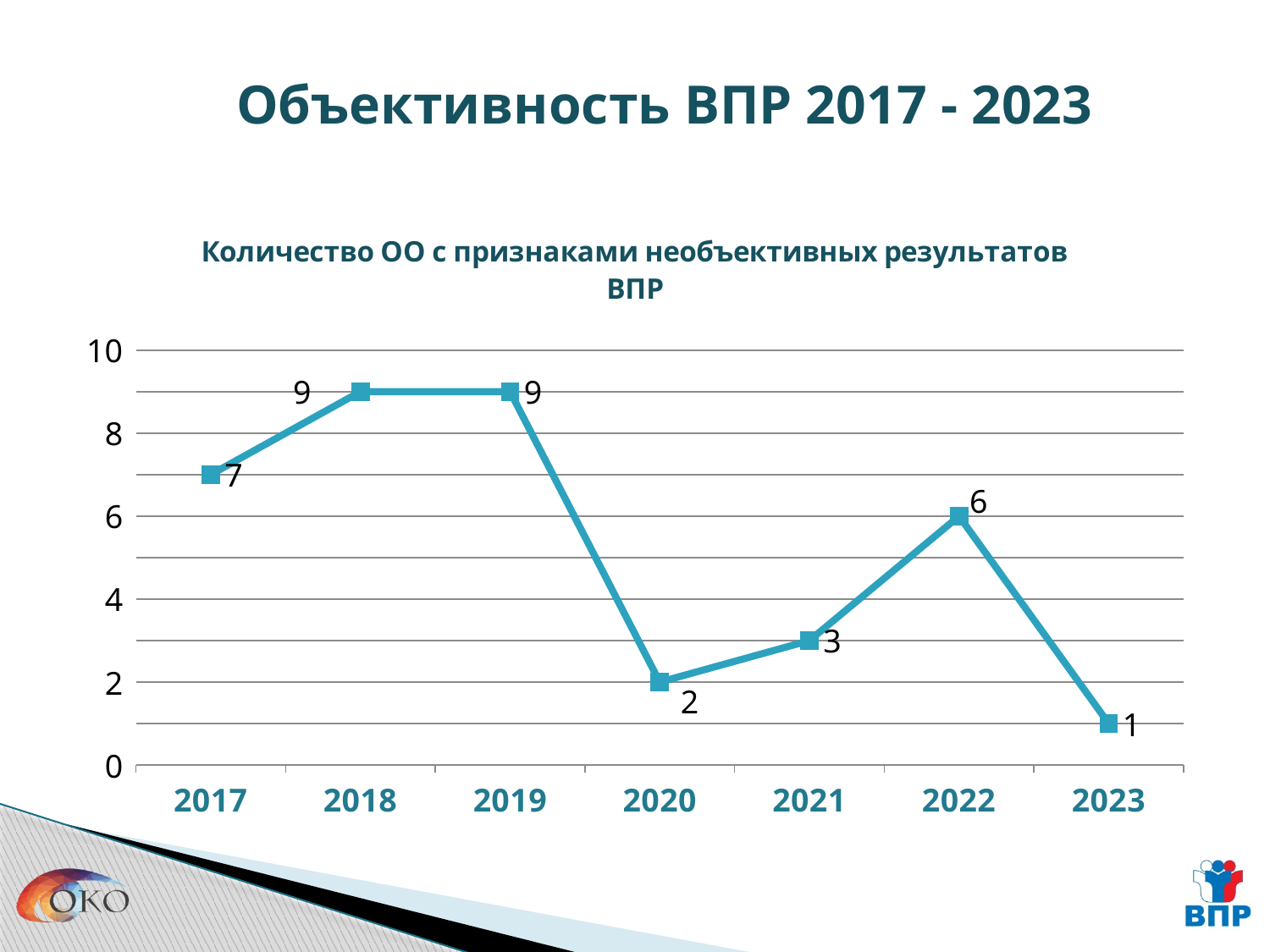
What is the value for 2023? 1 Which year has the lowest value? 2023 What is the difference between the values for 2019 and 2020? 7 What is the value for 2020? 2 What is the highest value shown on the chart? 9 Which is larger, the value for 2021 or the value for 2022? 2022 How many years are plotted on the chart? 7 What kind of chart is shown on the slide? line chart What is the value for 2022? 6 Does the value rise or fall from 2019 to 2020? fall What is the difference between the values for 2022 and 2023? 5 What is the value for 2017? 7